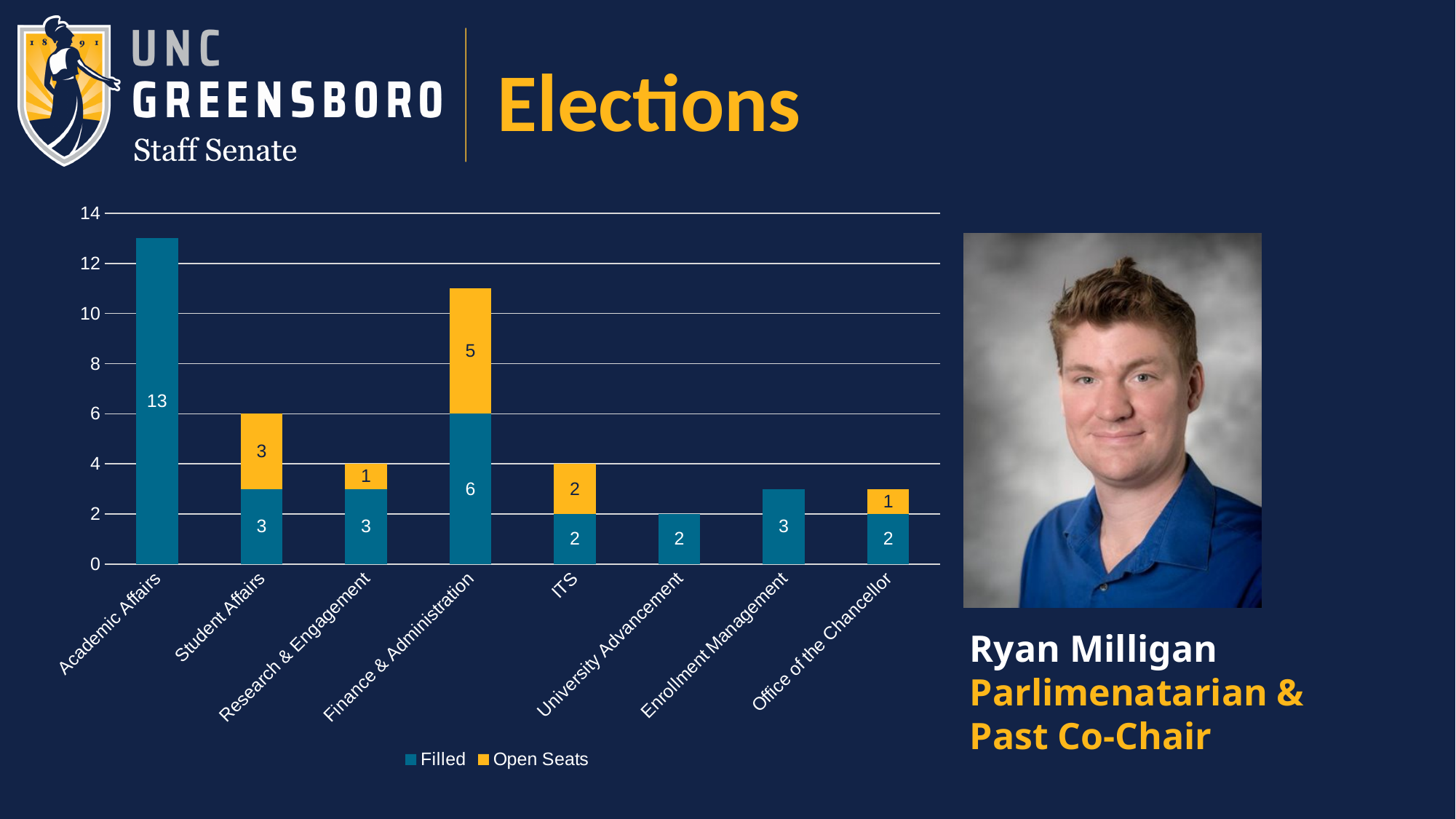
What is the Open Seats value for Finance & Administration? 5 What is the total of the stacked bar for Finance & Administration? 11 Which is larger, the Open Seats value for ITS or the Open Seats value for Research & Engagement? ITS Which category has the highest Open Seats value? Finance & Administration What kind of chart is shown on the slide? Stacked bar chart Which category has the highest Filled value? Academic Affairs What is the Filled value for Academic Affairs? 13 What is the Filled value for Enrollment Management? 3 What is the difference between the Filled values for Academic Affairs and Finance & Administration? 7 How many categories are shown on the x axis? 8 How many series does the legend list? 2 What is the total of the stacked bar for Student Affairs? 6